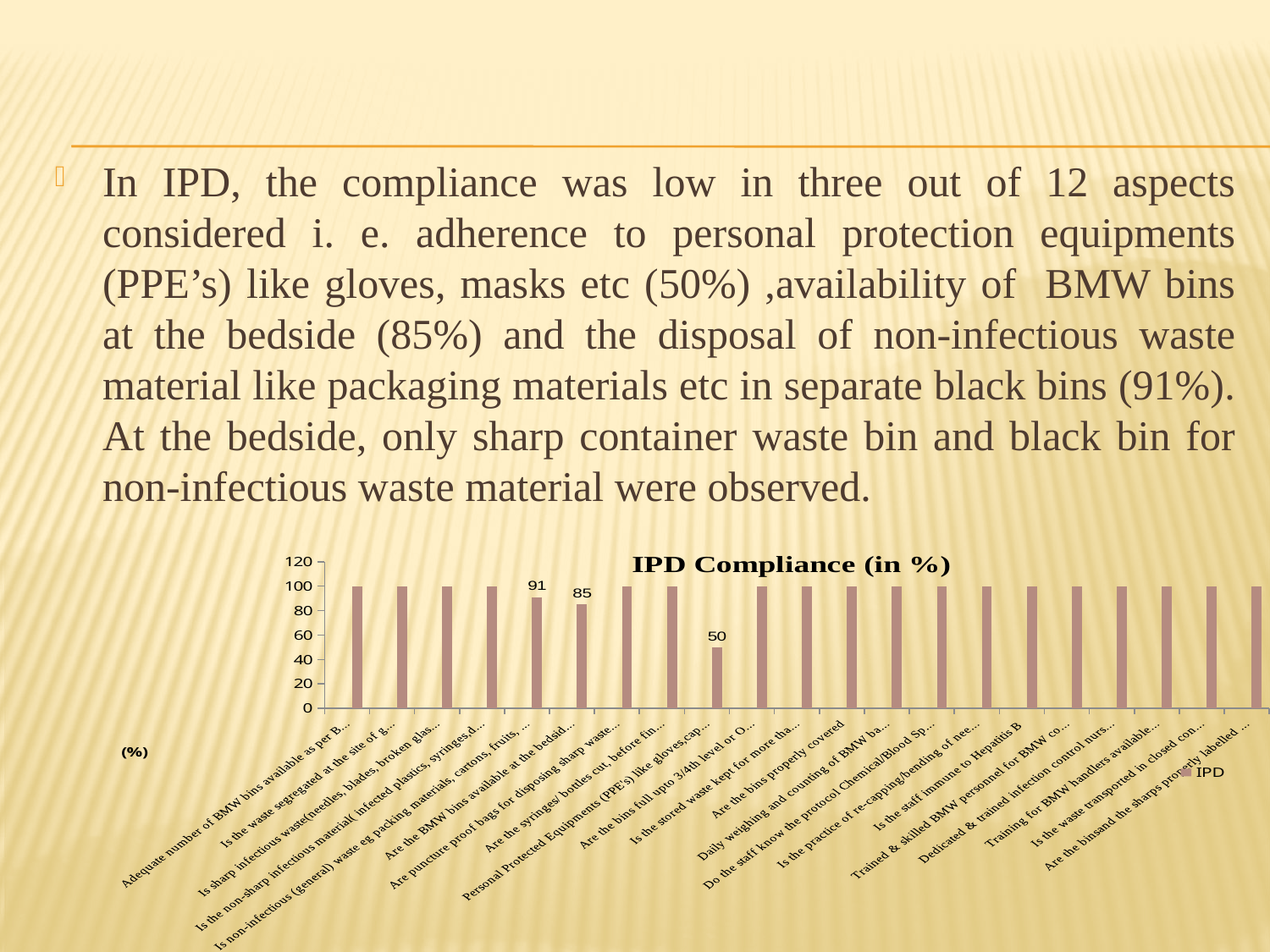
What kind of chart is shown on the slide? bar chart What is the value shown for "Is non-infectious (general) waste eg packing materials, cartons, fruits..."? 91 Which is larger: the value for "Are the BMW bins available at the bedside" or the value for "Personal Protected Equipments (PPE's)"? Are the BMW bins available at the bedside Is the value for "Are the bins properly covered" greater or less than 80? greater What is the title of the chart? IPD Compliance (in %) What is the compliance value for "Personal Protected Equipments (PPE's) like gloves, cap..."? 50 Which category has the lowest compliance value in the chart? Personal Protected Equipments (PPE's) like gloves, cap... Is the value for "Personal Protected Equipments (PPE's)" greater or less than 60? less What is the value for "Are the BMW bins available at the bedside" in the IPD Compliance chart? 85 How much higher is the value for BMW bins available at the bedside than the value for Personal Protected Equipments (PPE's)? 35 What is the difference between the value for non-infectious (general) waste (91) and the value for BMW bins available at the bedside (85)? 6 How many series does the legend list? 1